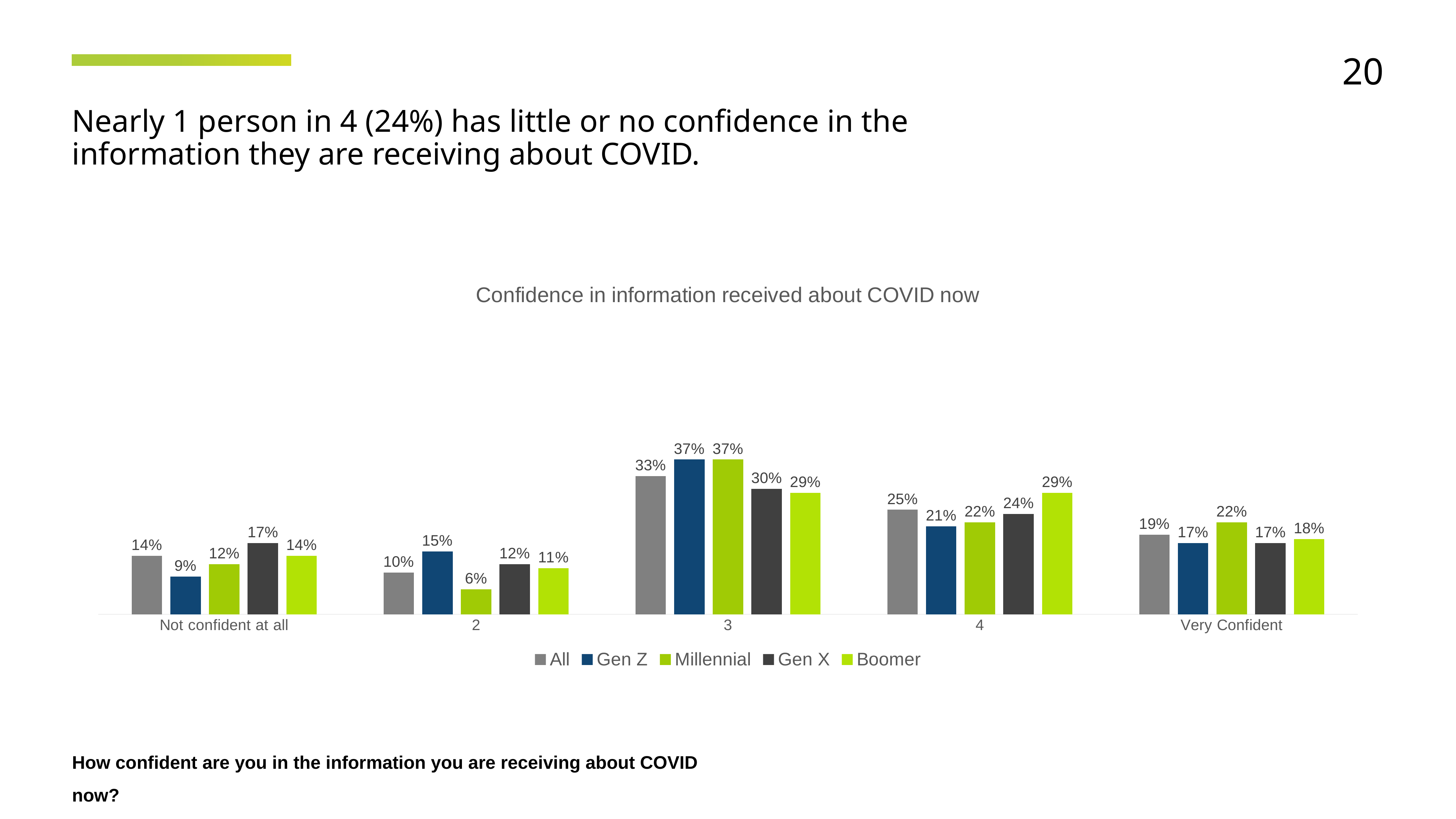
What is the title of the chart? Confidence in information received about COVID now What is the value for Millennial in category 2? 6% How many series does the legend list? 5 Which series has the lowest value in category 2? Millennial What is the value for Gen Z in the "Not confident at all" category? 9% What is the difference between the Gen X and Gen Z values in the "Not confident at all" category? 8% Which category has the highest value for the All series? 3 What is the value for Boomer in category 4? 29% What is the value for All in the "Very Confident" category? 19% What kind of chart is shown on the slide? Bar chart How many categories are shown on the x axis? 5 In category 3, which is larger: the value for Gen Z or the value for Gen X? Gen Z